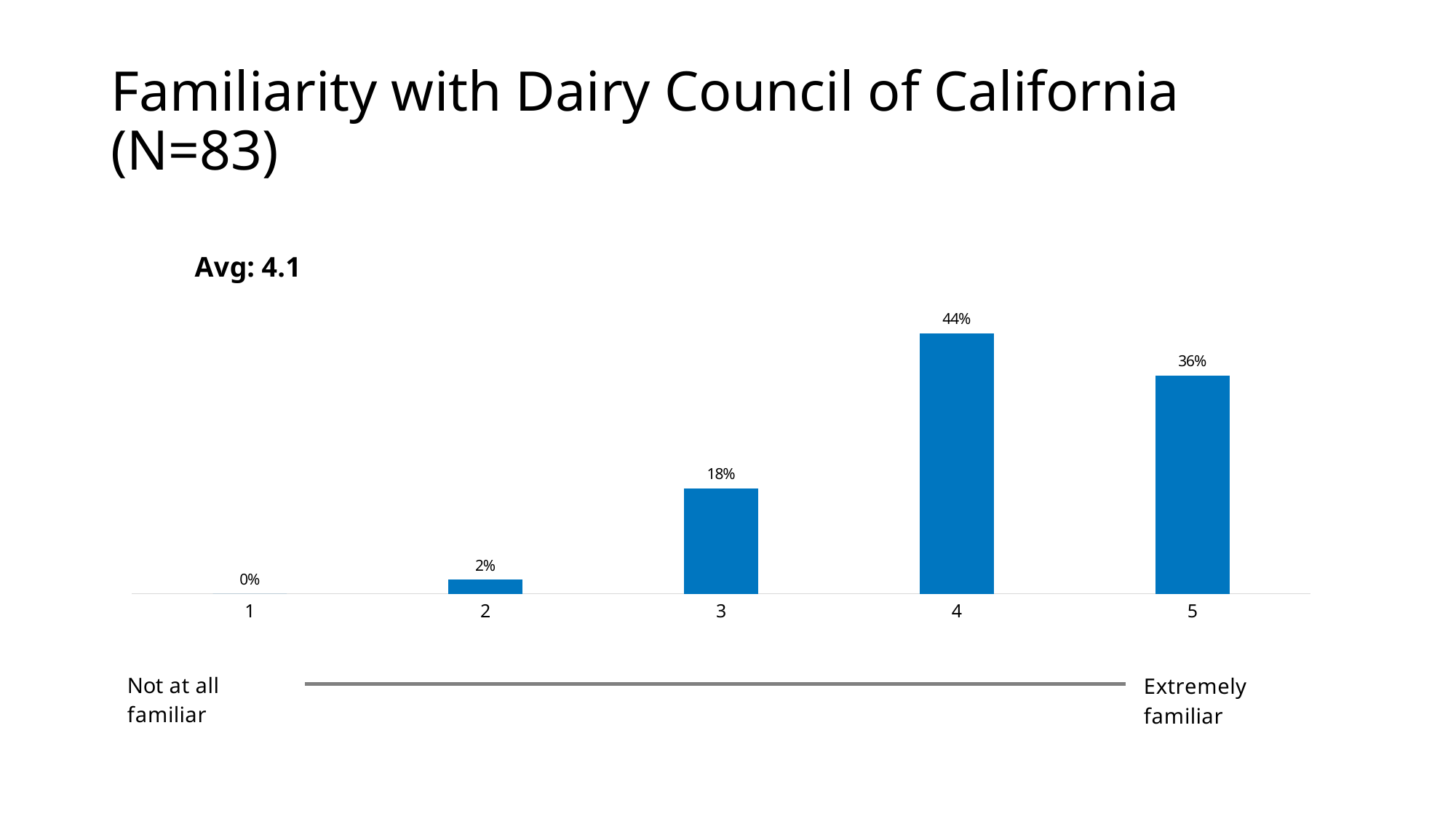
Which rating has the lowest percentage of respondents? 1 Which has a larger percentage, rating 3 or rating 5? 5 What percentage of respondents rated their familiarity as 1? 0% What is the difference in percentage points between rating 3 and rating 2? 16 How many rating categories are shown on the x axis? 5 What percentage of respondents rated their familiarity as 4? 44% What is the difference in percentage points between rating 4 and rating 5? 8 What percentage of respondents rated their familiarity as 5? 36% What average familiarity score is shown on the slide? 4.1 Which rating has the highest percentage of respondents? 4 What percentage of respondents rated their familiarity as 2? 2% What percentage of respondents rated their familiarity as 3? 18%